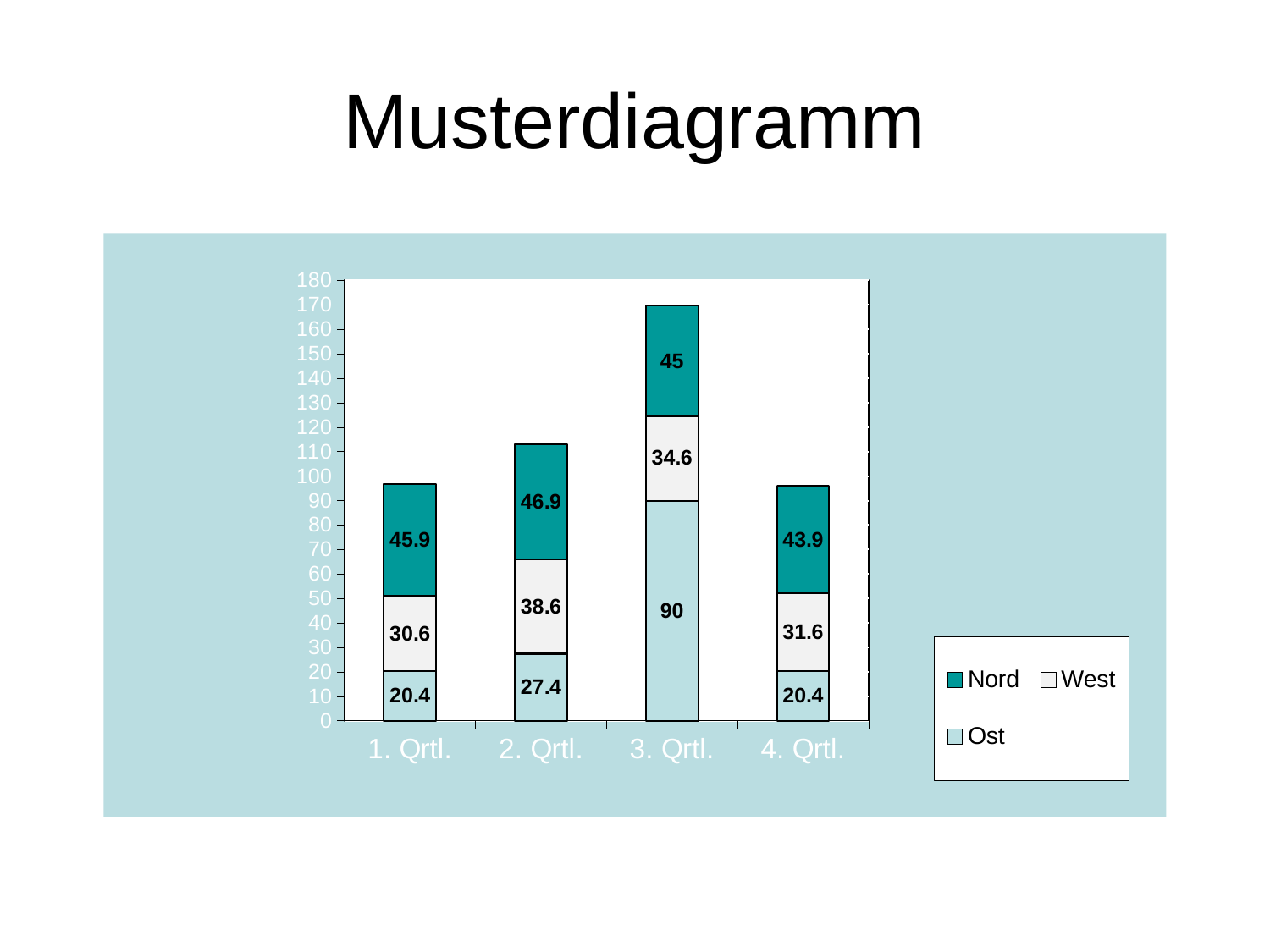
Which quarter has the highest value for Ost? 3. Qrtl. What is the value for Ost in 3. Qrtl.? 90 What is the difference between the West values for 2. Qrtl. and 1. Qrtl.? 8 How many series does the legend list? 3 Which quarter has the lowest value for Nord? 4. Qrtl. What is the total of the stacked bar for 1. Qrtl.? 96.9 What is the value for Nord in 2. Qrtl.? 46.9 Which is larger: the Nord value in 1. Qrtl. or the Nord value in 3. Qrtl.? 1. Qrtl. What is the value for West in 4. Qrtl.? 31.6 Is the total height of the 3. Qrtl. bar greater or less than 150? greater How many quarters are shown on the x axis? 4 What kind of chart is shown on the slide? stacked bar chart